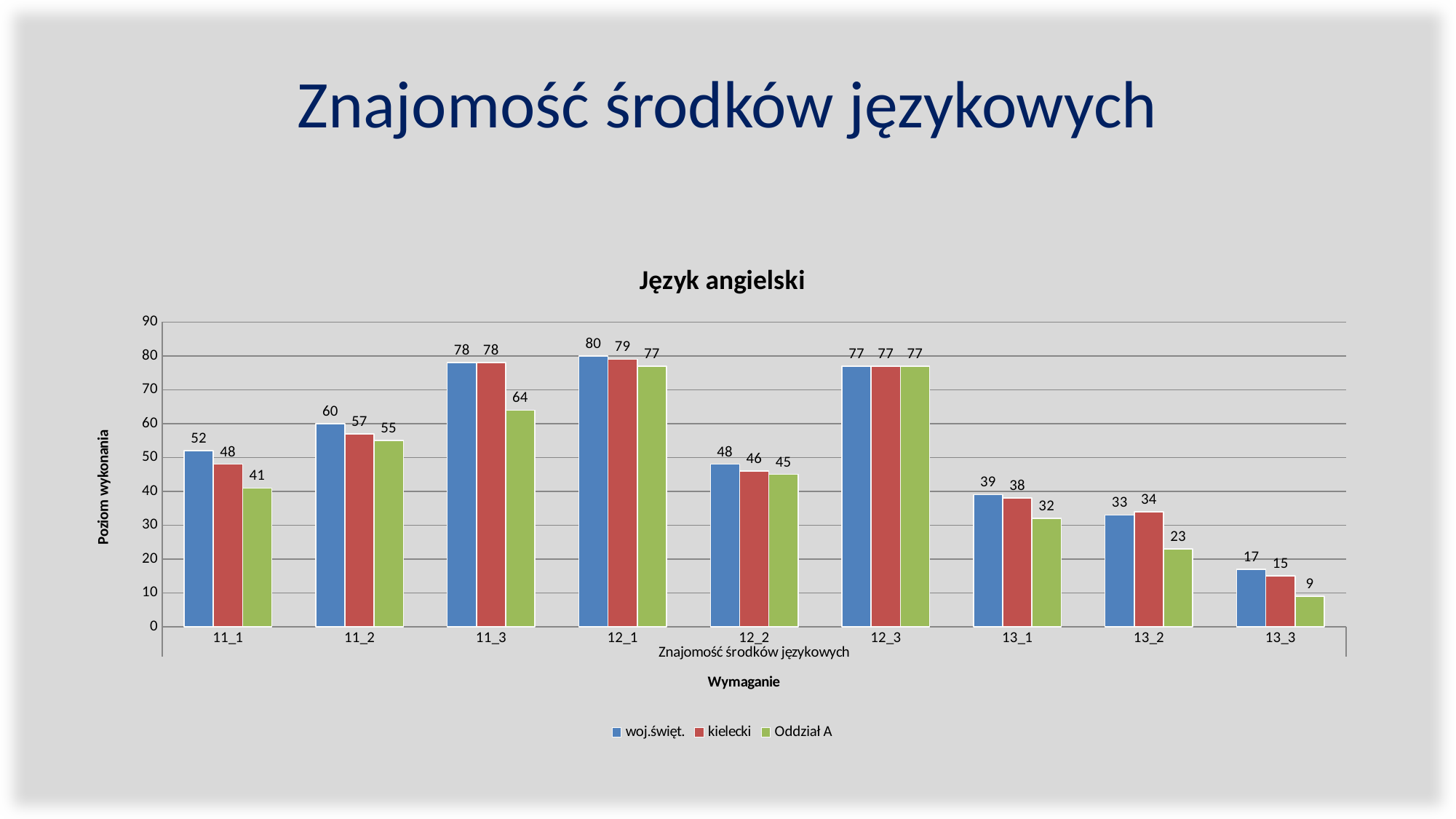
How many categories are shown on the x axis? 9 Which category has the lowest value for Oddział A? 13_3 What is the difference between the woj.święt. and Oddział A values in category 11_1? 11 What kind of chart is shown on the slide? bar chart What is the title of the chart? Język angielski What is the value for woj.święt. in category 12_1? 80 Which category has the highest value for woj.święt.? 12_1 What is the value for kielecki in category 13_2? 34 What is the value for Oddział A in category 11_3? 64 Which is larger in category 13_2: the woj.święt. value or the kielecki value? kielecki How many series does the legend list? 3 Is the value for Oddział A in category 12_2 greater or less than 50? less